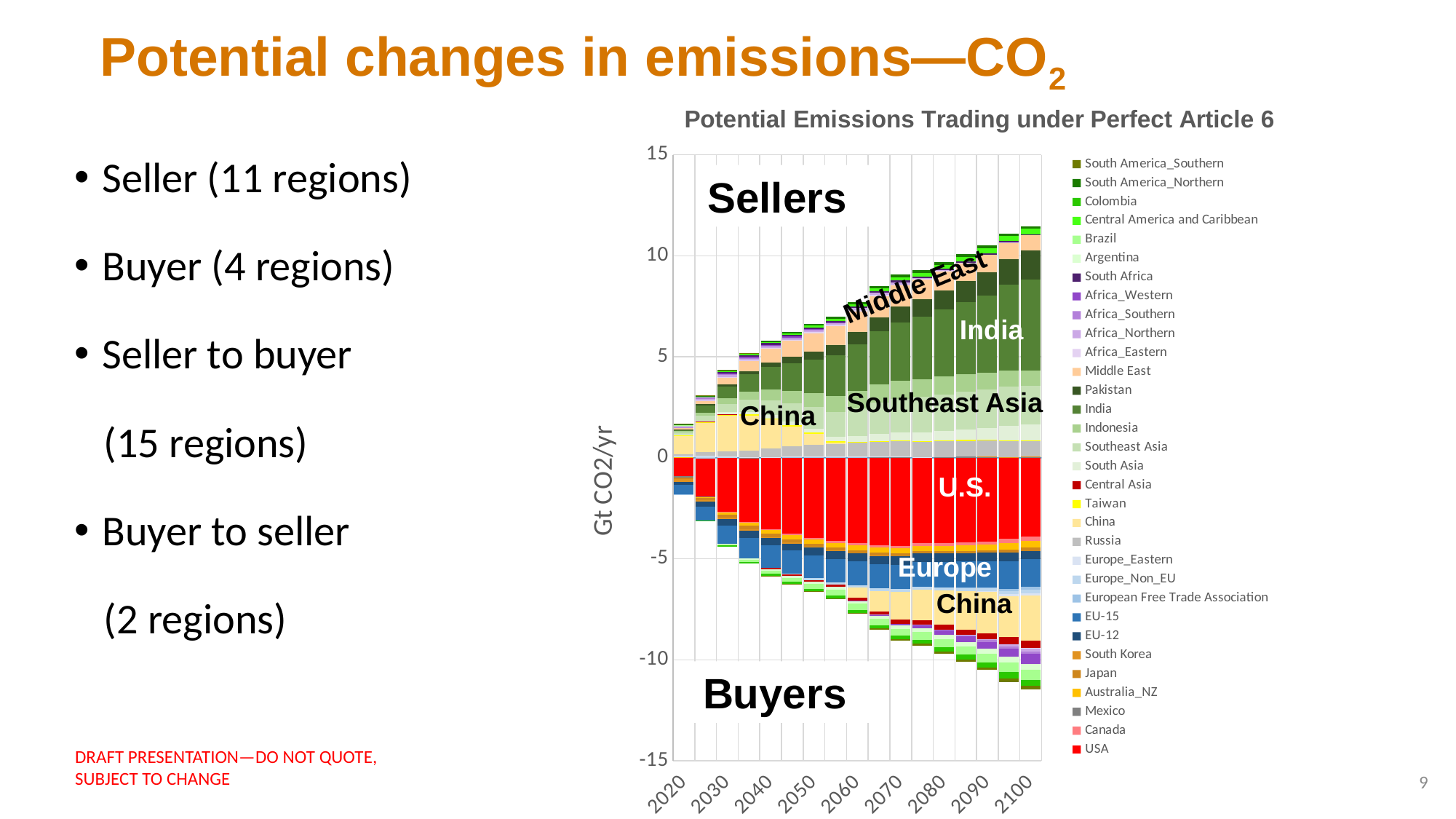
How many year labels are shown along the x axis of the chart? 9 Which year has the larger positive (Sellers) stack total, 2020 or 2100? 2100 Is the bottom of the negative (Buyers) stack for 2100 greater or less than -10 Gt CO2/yr? less Is the total of the positive (Sellers) stack for 2100 greater or less than 10 Gt CO2/yr? greater What is the label on the vertical axis of the chart? Gt CO2/yr What type of chart is shown on the slide? Stacked bar chart Is the total of the positive (Sellers) stack for 2020 greater or less than 5 Gt CO2/yr? less Does the total of the positive (Sellers) stack rise or fall from 2020 to 2100? rise What is the title of the chart? Potential Emissions Trading under Perfect Article 6 How many series does the chart's legend list? 32